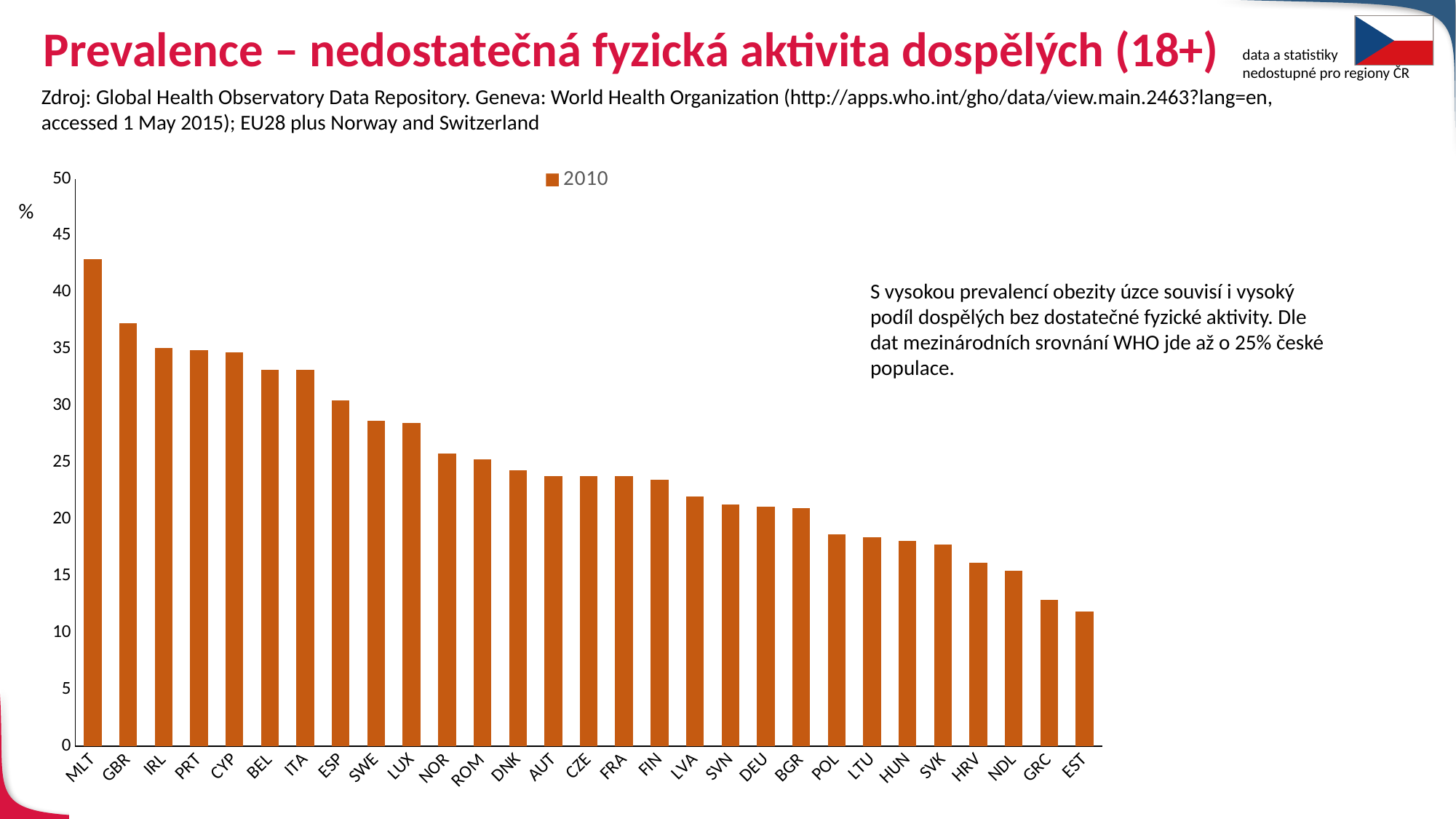
Is the value for CZE greater or less than 25? less Is the value for MLT greater or less than 40? greater Is the value for EST greater or less than 15? less What kind of chart is shown on the slide? bar chart What year does the chart legend show? 2010 How many countries are shown on the x axis of the chart? 29 Which has a larger value, GBR or IRL? GBR Do the values rise or fall moving from left to right along the x axis? fall Which country has the lowest value in the chart? EST How many series does the chart legend list? 1 Which country has the highest value in the chart? MLT